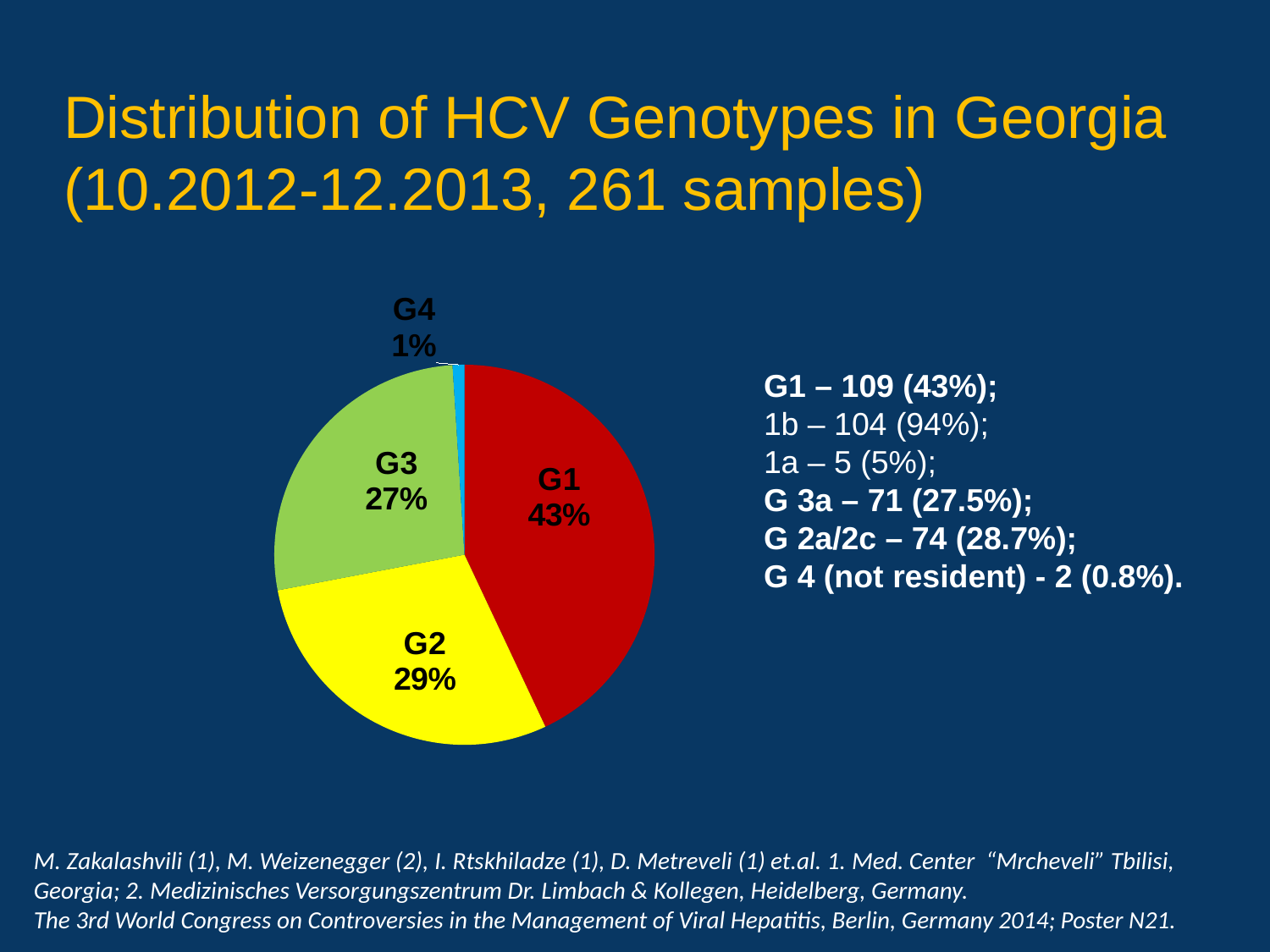
What is the title of the slide containing the pie chart? Distribution of HCV Genotypes in Georgia (10.2012-12.2013, 261 samples) Which slice is larger, G2 or G3? G2 What kind of chart is shown on the slide? pie chart Which genotype has the smallest share of the pie? G4 What is the difference in percentage points between the G1 and G3 slices? 16 Which genotype has the largest share of the pie? G1 What percentage of the pie does G4 account for? 1% What colour is the G1 slice of the pie? red What percentage of the pie does G2 account for? 29% What percentage of the pie does G1 account for? 43% What percentage of the pie does G3 account for? 27% How many slices does the pie chart have? 4